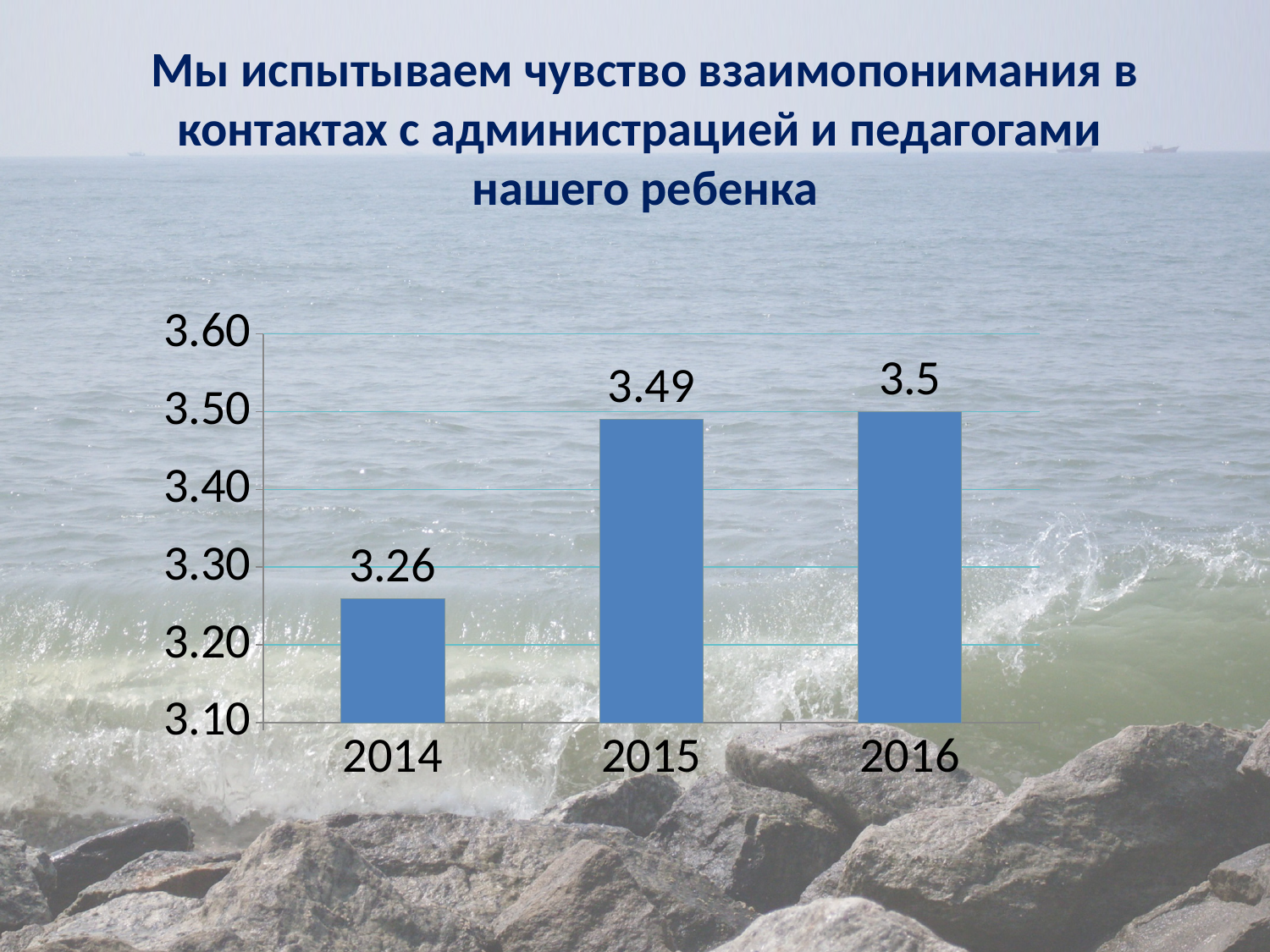
What kind of chart is shown on the slide? bar chart Which is larger, the value for 2014 or the value for 2015? 2015 What is the value for 2014? 3.26 Which year has the highest value? 2016 What is the difference between the values for 2015 and 2014? 0.23 Do the values rise or fall from 2014 to 2016? rise What is the value for 2016? 3.5 How many years are shown on the x axis? 3 Is the value for 2014 greater or less than 3.30? less What is the value for 2015? 3.49 What is the difference between the values for 2016 and 2014? 0.24 Which year has the lowest value? 2014